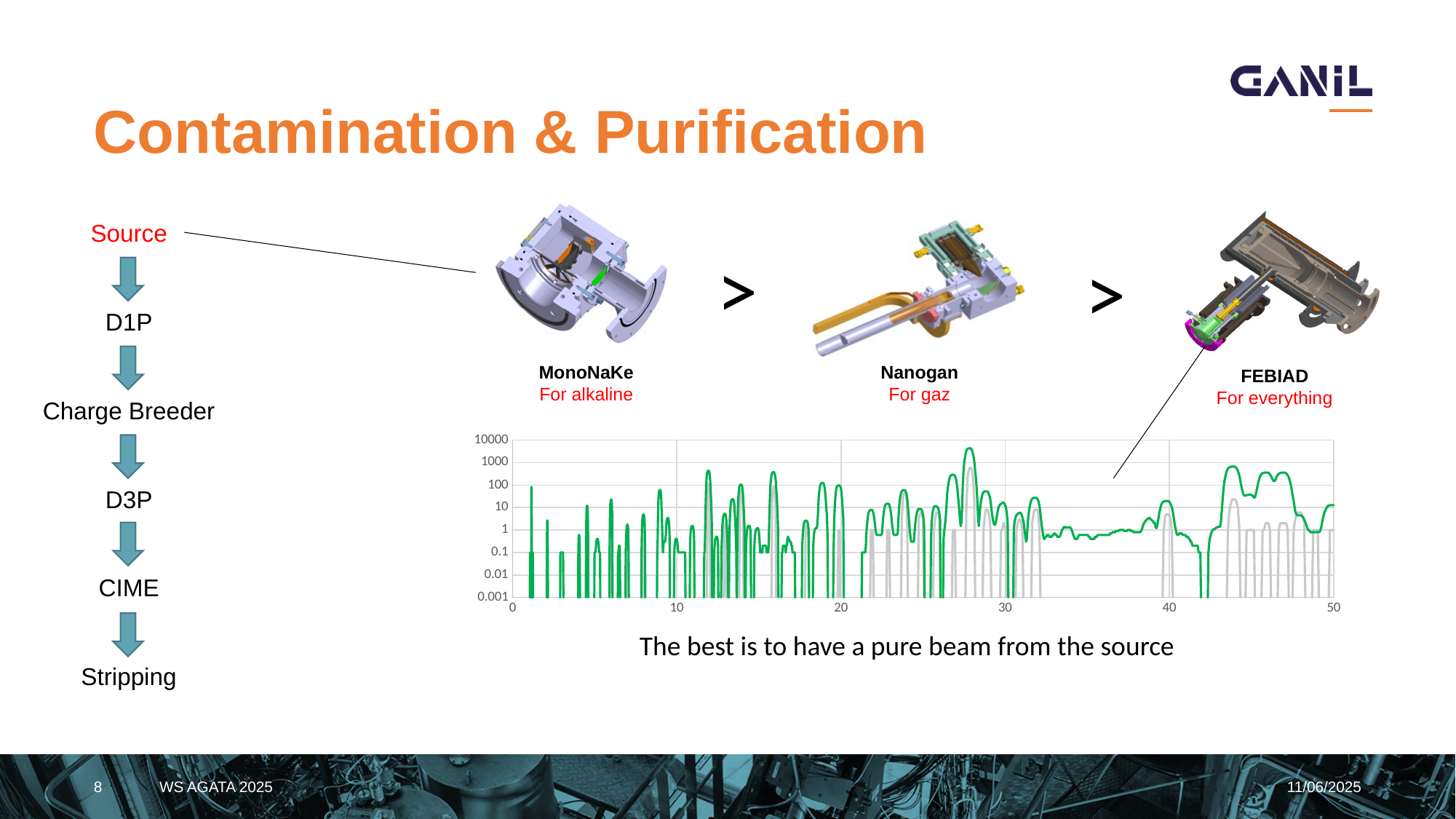
What is the lowest tick value shown on the y-axis of the chart? 0.001 Does the highest peak of the green line occur between x = 20 and x = 30? yes What is the highest tick value shown on the y-axis of the chart? 10000 Is the highest peak of the grey line greater or less than 100? greater Is the value of the green line at x = 35 greater or less than 10? less Which line reaches a higher peak overall, the green line or the grey line? green line What is the largest tick value shown on the x-axis of the chart? 50 Is the highest peak of the green line greater or less than 1000? greater What kind of chart is shown on the slide? line chart